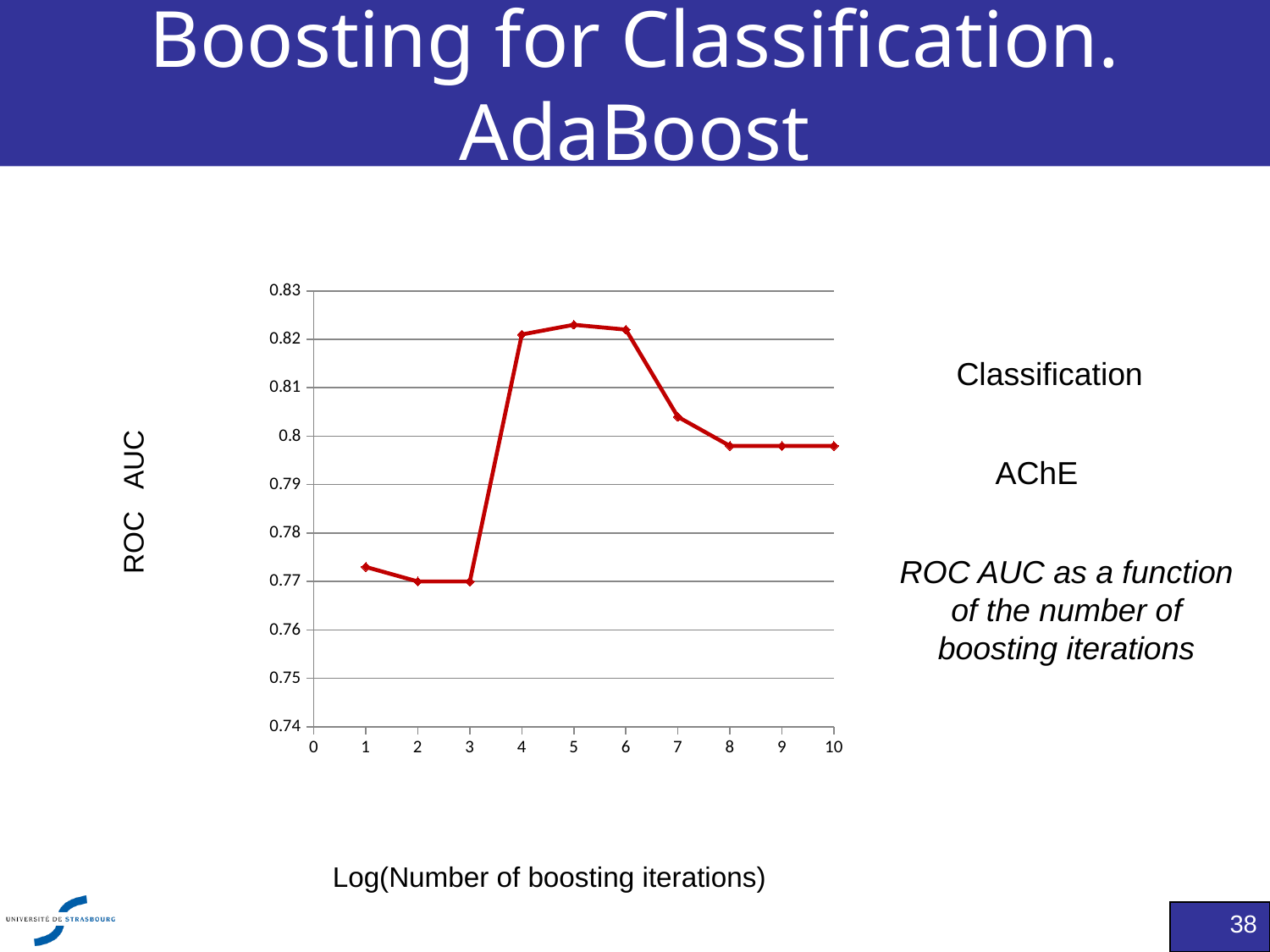
What kind of chart is shown on the slide? line chart What is the ROC AUC value at x = 3? 0.77 Is the ROC AUC value at x = 1 greater or less than 0.78? less Which has the larger ROC AUC value, x = 4 or x = 1? x = 4 Is the ROC AUC value at x = 8 greater or less than 0.8? less How many data points are plotted on the line? 10 Does the ROC AUC rise or fall between x = 6 and x = 8? fall Is the ROC AUC value at x = 7 greater or less than 0.8? greater What is the label of the x axis? Log(Number of boosting iterations) What is the label of the y axis? ROC AUC What is the ROC AUC value at x = 2? 0.77